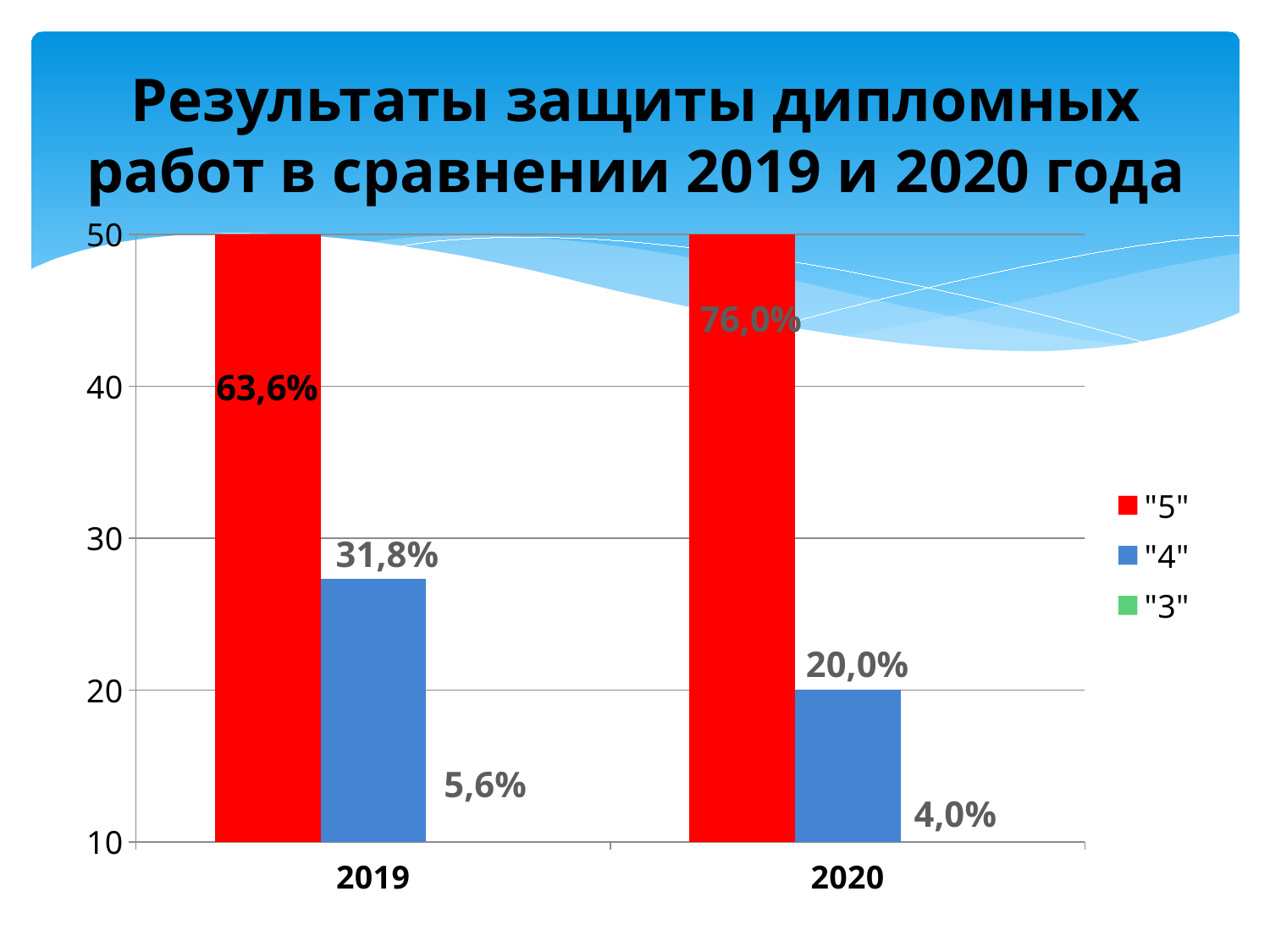
What is the value for "4" in 2019? 31,8% Which series has the highest value in 2020? "5" Which is larger: the value for "4" in 2019 or in 2020? 2019 How many series does the legend list? 3 What is the value for "5" in 2019? 63,6% Which series has the lowest value in 2019? "3" Does the value for "5" rise or fall from 2019 to 2020? Rise What is the difference between the "4" values in 2019 and 2020? 11,8% What is the value for "3" in 2020? 4,0% What kind of chart is shown on the slide? Bar chart By how much did the value for "5" change from 2019 to 2020? 12,4% What is the value for "5" in 2020? 76,0%